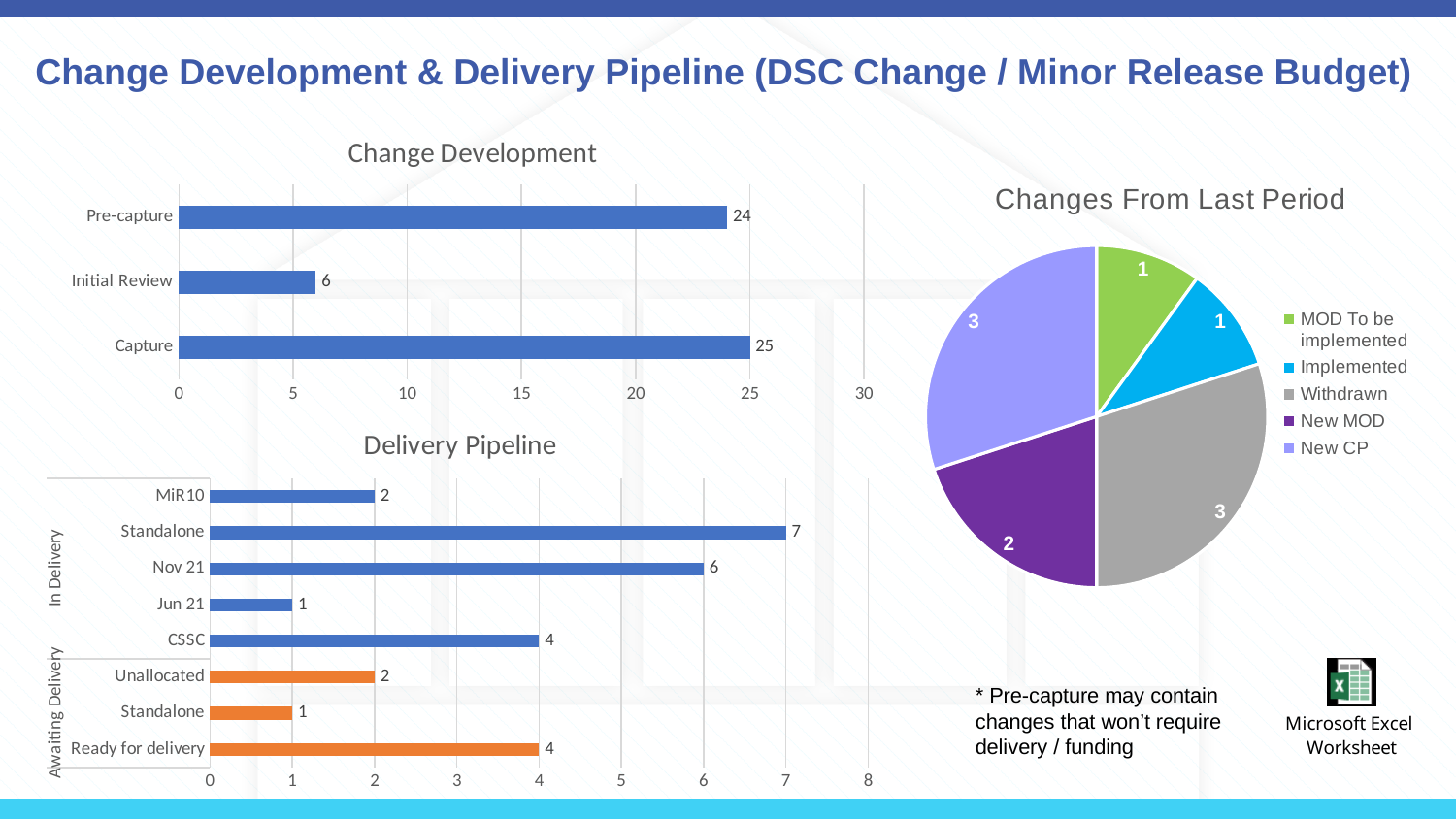
In the Delivery Pipeline chart, how many categories are shown? 8 In the Delivery Pipeline chart, what is the value for Nov 21? 6 In the Changes From Last Period pie chart, what is the value for New MOD? 2 In the Change Development chart, what is the value for Pre-capture? 24 In the Delivery Pipeline chart, which category has the highest value? Standalone (In Delivery) In the Delivery Pipeline chart, which is larger, CSSC or Unallocated? CSSC In the Changes From Last Period pie chart, what share of the total does Withdrawn represent? 30% In the Change Development chart, which category has the lowest value? Initial Review How many entries does the legend of the Changes From Last Period pie chart list? 5 In the Change Development chart, how many categories are shown? 3 In the Change Development chart, what is the difference between Capture and Initial Review? 19 What kind of chart is the Delivery Pipeline chart? Bar chart